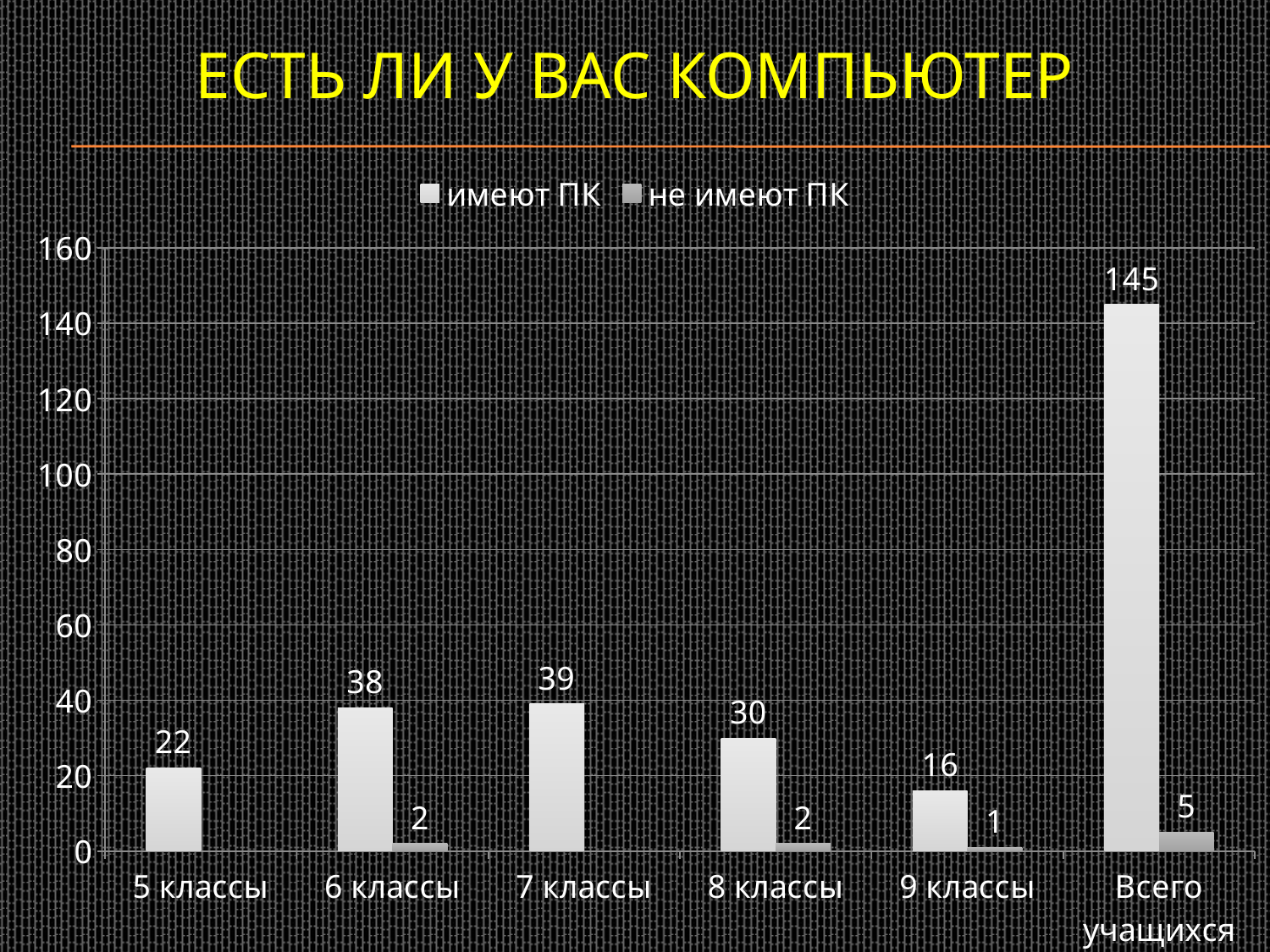
What is the value of 'не имеют ПК' for 9 классы? 1 Among the class categories (5 to 9 классы), which has the highest 'имеют ПК' value? 7 классы What is the value of 'имеют ПК' for Всего учащихся? 145 What is the difference between the 'имеют ПК' values for 6 классы and 5 классы? 16 Among the class categories (5 to 9 классы), which has the lowest 'имеют ПК' value? 9 классы Is the 'имеют ПК' value for Всего учащихся greater or less than 140? greater What is the value of 'имеют ПК' for 7 классы? 39 Which is larger: the 'имеют ПК' value for 8 классы or for 9 классы? 8 классы How many series does the legend list? 2 How many categories are shown on the x axis? 6 What is the title of the chart on the slide? ЕСТЬ ЛИ У ВАС КОМПЬЮТЕР What type of chart is shown on the slide? bar chart